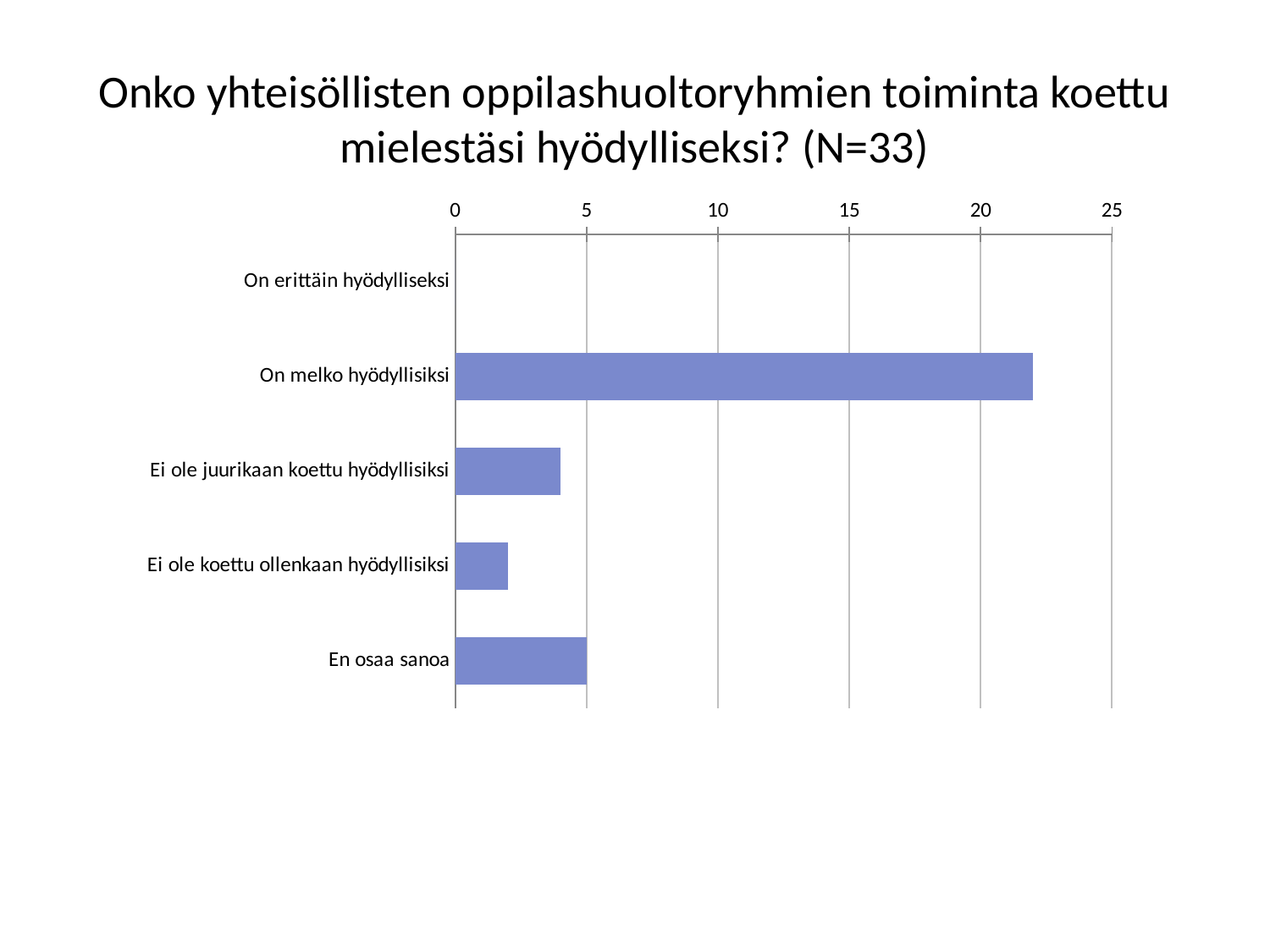
Is the value for Ei ole koettu ollenkaan hyödyllisiksi greater or less than 5? less What is the value for En osaa sanoa? 5 Which category has the highest value? On melko hyödyllisiksi Is the value for On melko hyödyllisiksi greater or less than 20? greater Which is larger, the value for En osaa sanoa or the value for On melko hyödyllisiksi? On melko hyödyllisiksi Which is larger, the value for Ei ole juurikaan koettu hyödyllisiksi or the value for Ei ole koettu ollenkaan hyödyllisiksi? Ei ole juurikaan koettu hyödyllisiksi What is the title of the chart? Onko yhteisöllisten oppilashuoltoryhmien toiminta koettu mielestäsi hyödylliseksi? (N=33) What kind of chart is shown on the slide? Bar chart Is the value for Ei ole juurikaan koettu hyödyllisiksi greater or less than 5? less Which category has the lowest value? On erittäin hyödylliseksi How many categories are shown on the chart? 5 What is the highest value shown on the value axis? 25